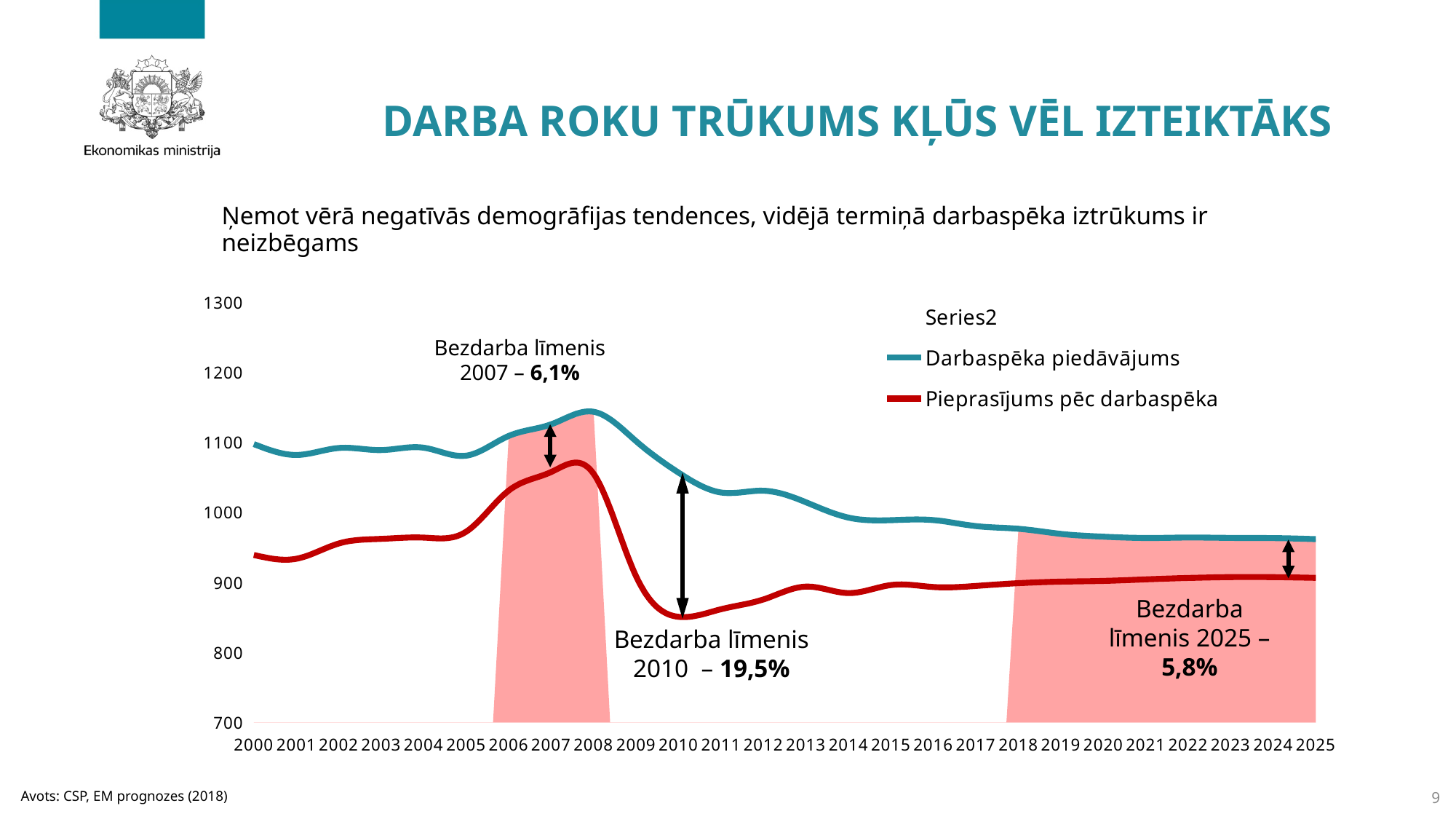
How many years are shown on the x axis of the chart? 26 What unemployment rate is annotated on the chart for 2010? 19,5% What kind of chart is shown on the slide? line chart Is the value of Darbaspēka piedāvājums in 2025 greater or less than 1000? less Is the value of Darbaspēka piedāvājums in 2008 greater or less than 1100? greater In which year does Pieprasījums pēc darbaspēka reach its lowest value? 2010 Does Darbaspēka piedāvājums rise or fall from 2008 to 2025? fall Is the value of Pieprasījums pēc darbaspēka in 2010 greater or less than 900? less How many entries does the chart legend list? 3 In 2010, which is higher: Darbaspēka piedāvājums or Pieprasījums pēc darbaspēka? Darbaspēka piedāvājums Which series is plotted in blue? Darbaspēka piedāvājums